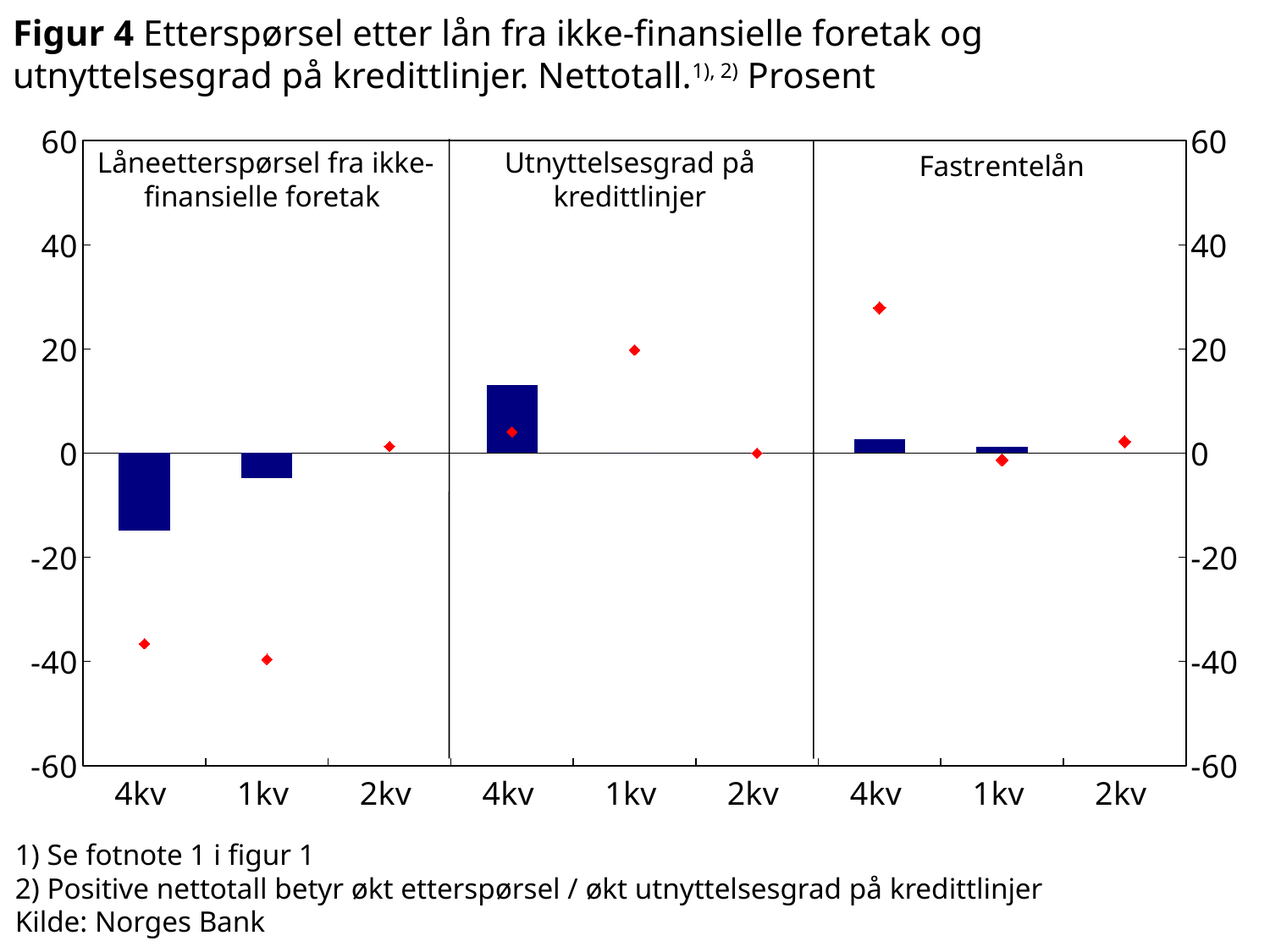
Which panel contains the lowest bar value in the chart? Låneetterspørsel fra ikke-finansielle foretak How many panels does the chart have? 3 In the 'Låneetterspørsel fra ikke-finansielle foretak' panel, do the bar values rise or fall from 4kv to 2kv? rise In the 'Låneetterspørsel fra ikke-finansielle foretak' panel, is the bar value for 4kv greater or less than 0? less In the 'Fastrentelån' panel, is the red marker for 4kv greater or less than 20? greater In the 'Utnyttelsesgrad på kredittlinjer' panel, is the bar value for 4kv greater or less than 20? less How many quarter categories are shown in each panel? 3 In the 'Utnyttelsesgrad på kredittlinjer' panel, which red marker is higher, 4kv or 1kv? 1kv What source is cited for the chart? Norges Bank What is the title of the third panel of the chart? Fastrentelån What kind of chart is shown on the slide? combination chart with bars and red diamond markers